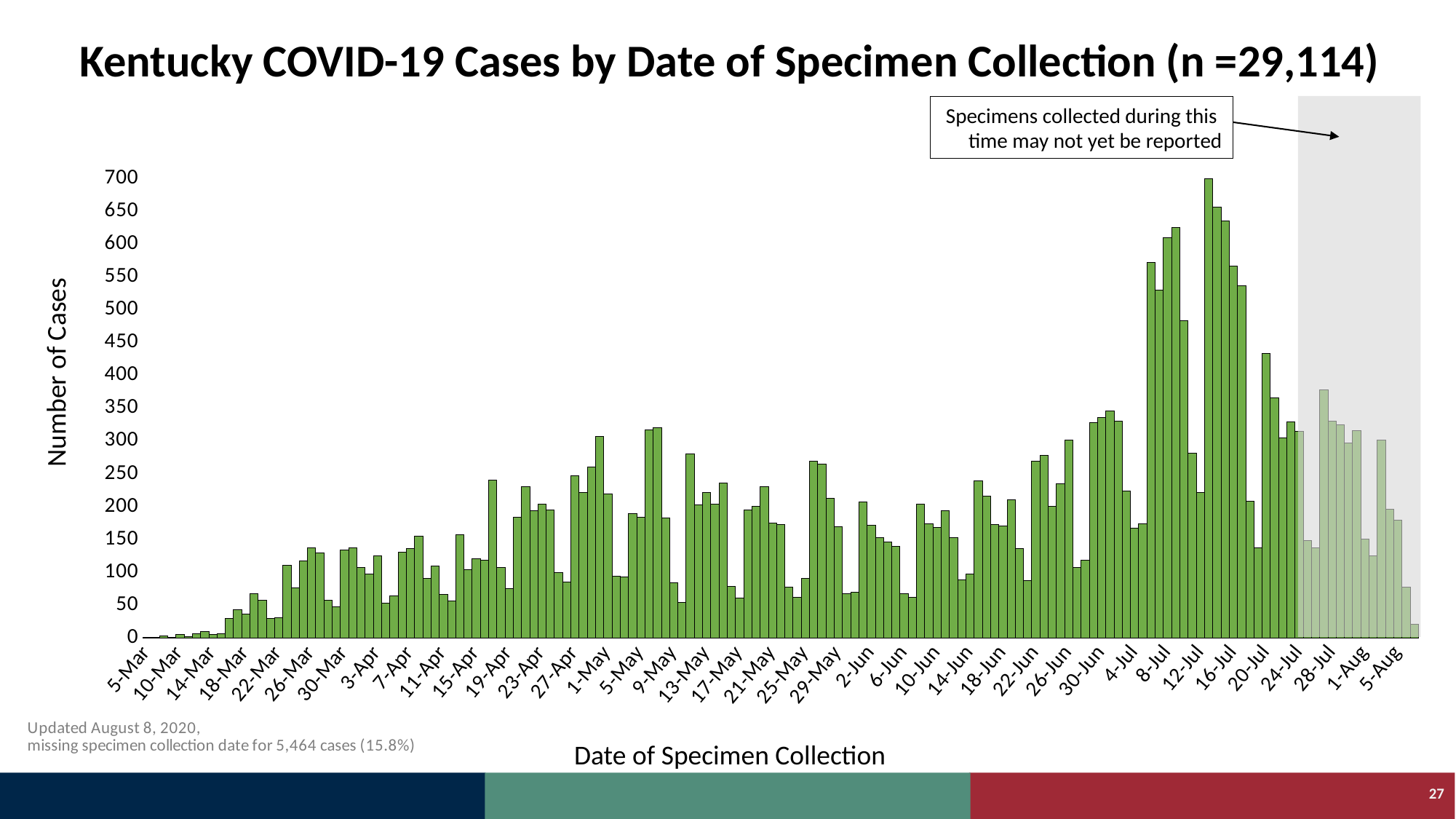
Is the value for 5-Mar greater or less than 50? less Do the values generally rise or fall from 16-Jul to 24-Jul? fall What is the title of the chart? Kentucky COVID-19 Cases by Date of Specimen Collection (n =29,114) What is the label on the vertical axis of the chart? Number of Cases Is the value for 30-Jun greater or less than 300? greater What kind of chart is shown on the slide? bar chart Which date has the higher number of cases, 12-Jul or 5-Mar? 12-Jul Is the value for 8-Jul greater or less than 500? greater Do the values generally rise or fall from 5-Mar to 18-Mar? rise Which date has the higher number of cases, 26-Mar or 26-Jun? 26-Jun